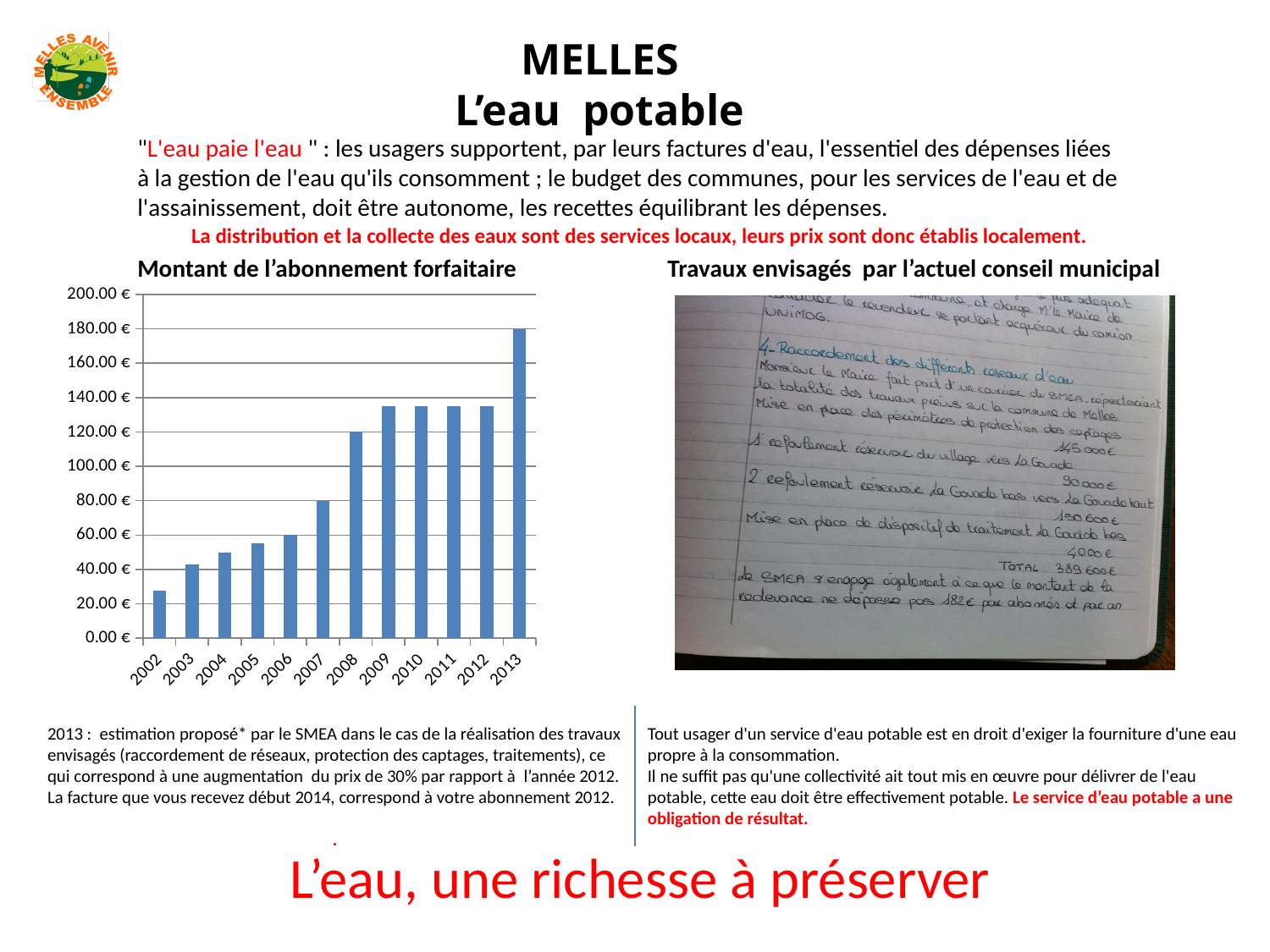
Is the value for 2009 greater or less than 120.00 €? greater What is the title of the chart on the slide? Montant de l'abonnement forfaitaire What is the value for 2013 in the chart? 180.00 € Is the value for 2002 greater or less than 40.00 €? less Do the values generally rise or fall from 2002 to 2013? rise What kind of chart is shown on the slide? bar chart How many years are plotted on the x axis of the chart? 12 Which year has the highest value in the chart? 2013 Which is larger, the value for 2008 or the value for 2007? 2008 What is the value for 2007 in the chart? 80.00 € Which year has the lowest value in the chart? 2002 Is the value for 2012 greater or less than 140.00 €? less